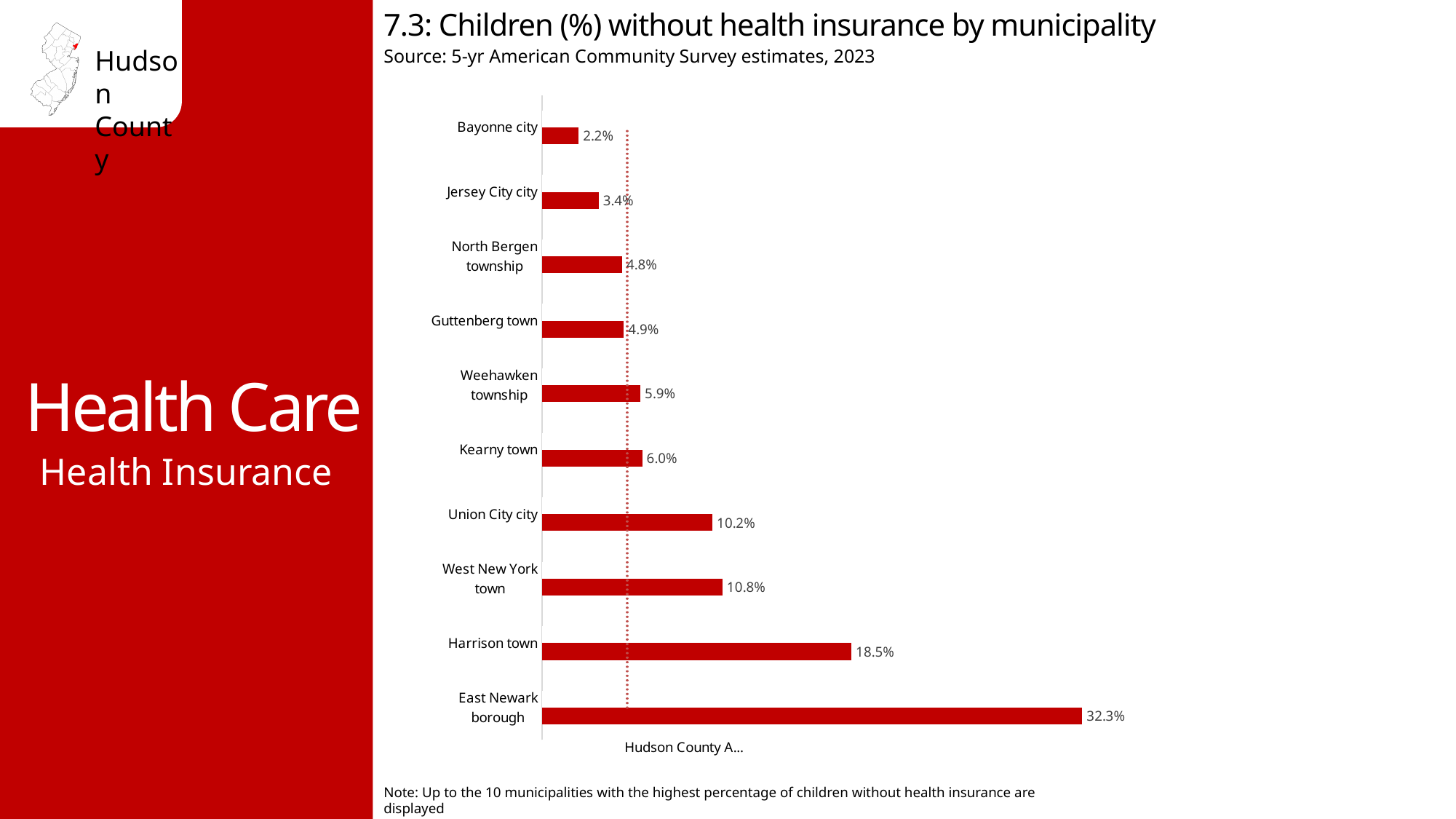
Which municipality has the lowest percentage of children without health insurance? Bayonne city Which has a higher value, Kearny town or Guttenberg town? Kearny town What is the source cited for the chart? 5-yr American Community Survey estimates, 2023 What percentage is shown for West New York town? 10.8% What is the difference between the values for Union City city and Jersey City city? 6.8% Which municipality has the highest percentage of children without health insurance? East Newark borough What is the difference between the values for East Newark borough and Harrison town? 13.8% What kind of chart is shown on the slide? Bar chart How many municipalities are shown in the chart? 10 What is the value shown for Harrison town? 18.5% What percentage of children are without health insurance in Bayonne city? 2.2% What does the dotted vertical line on the chart represent, according to its label? Hudson County A...